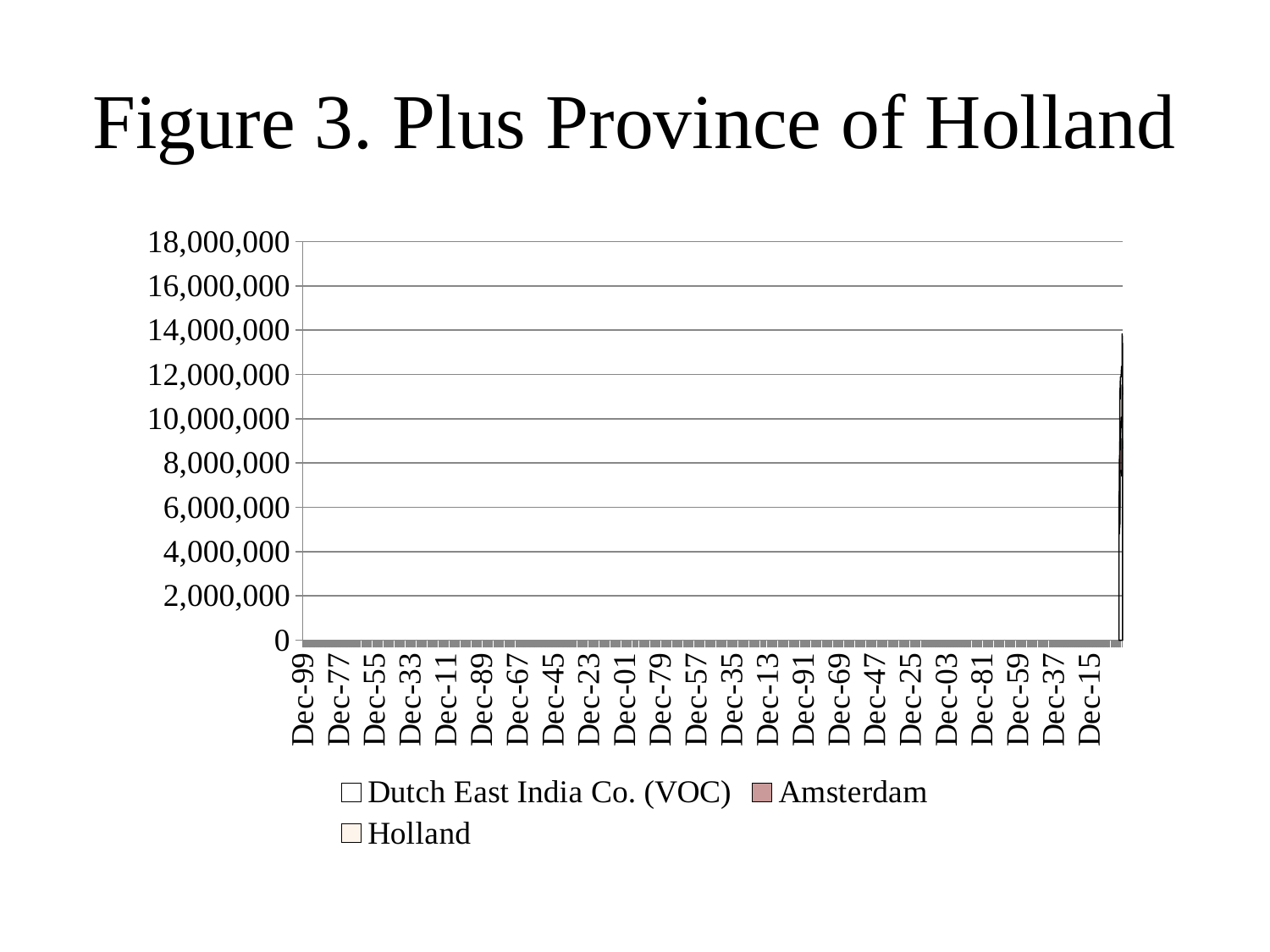
Do the plotted values stay near zero or rise steadily across most of the horizontal axis before the spike at the far right? stay near zero How many series does the chart's legend list? 3 Is the peak value at the far right of the chart greater or less than 16,000,000? less Is the peak value at the far right of the chart greater or less than 12,000,000? greater What is the interval between consecutive tick marks on the chart's vertical axis? 2,000,000 What is the first label on the chart's horizontal axis? Dec-99 What is the title of the slide containing the chart? Figure 3. Plus Province of Holland What is the highest value shown on the chart's vertical axis? 18,000,000 What is the last readable label on the chart's horizontal axis? Dec-15 Which three series are listed in the chart's legend? Dutch East India Co. (VOC), Amsterdam, Holland